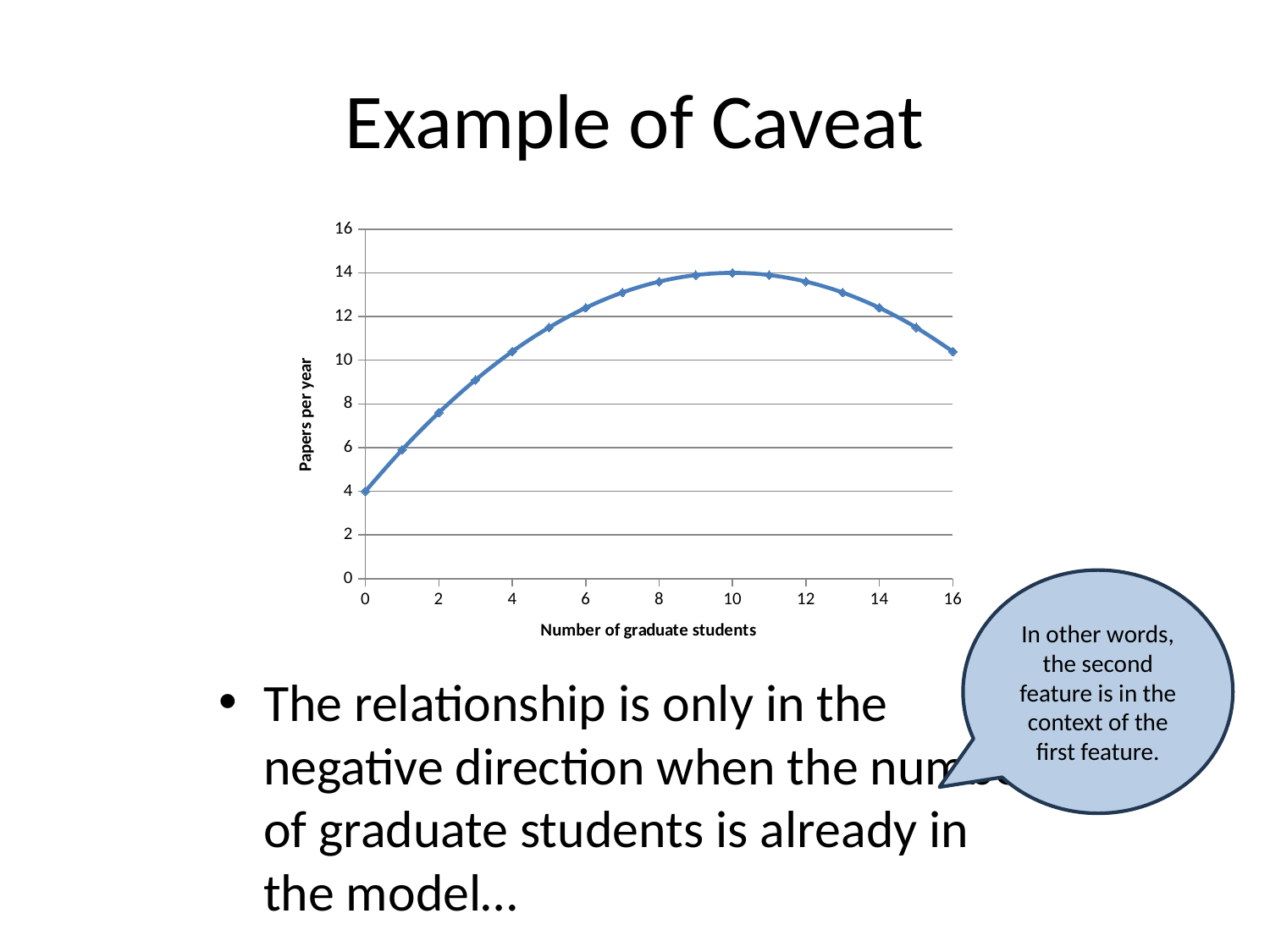
What is the title of the x axis of the chart? Number of graduate students Is the value of papers per year at 16 graduate students greater or less than 12? less What is the value of papers per year when the number of graduate students is 10? 14 At which number of graduate students is papers per year highest? 10 What is the value of papers per year when the number of graduate students is 0? 4 At which number of graduate students is papers per year lowest? 0 How do the values change as the number of graduate students increases from 0 to 16? rise then fall Which is larger, papers per year at 2 graduate students or at 14 graduate students? 14 graduate students What is the title of the y axis of the chart? Papers per year Is the value of papers per year at 6 graduate students greater or less than 12? greater How many data points are plotted on the line? 17 What kind of chart is shown on the slide? line chart